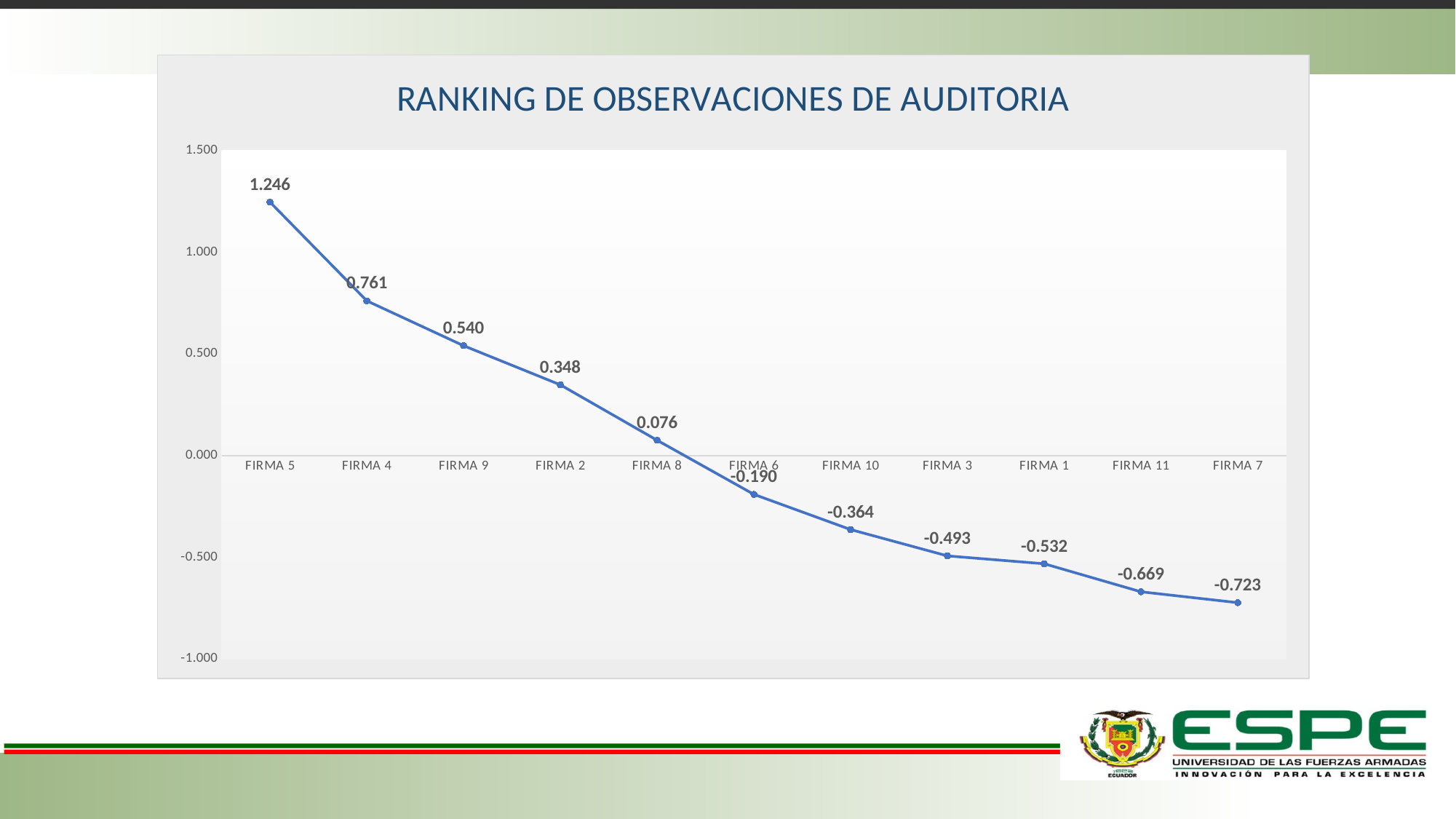
Is the value for FIRMA 10 greater or less than 0.000? less What is the value for FIRMA 8? 0.076 What kind of chart is shown? line chart How many categories are plotted on the x axis? 11 What is the value for FIRMA 11? -0.669 What is the value for FIRMA 5? 1.246 Do the values rise or fall from left to right along the x axis? fall Which category has the lowest value? FIRMA 7 What is the title of the chart? RANKING DE OBSERVACIONES DE AUDITORIA Which category has the highest value? FIRMA 5 Which is larger, the value for FIRMA 2 or the value for FIRMA 6? FIRMA 2 What is the difference between the values for FIRMA 4 and FIRMA 9? 0.221